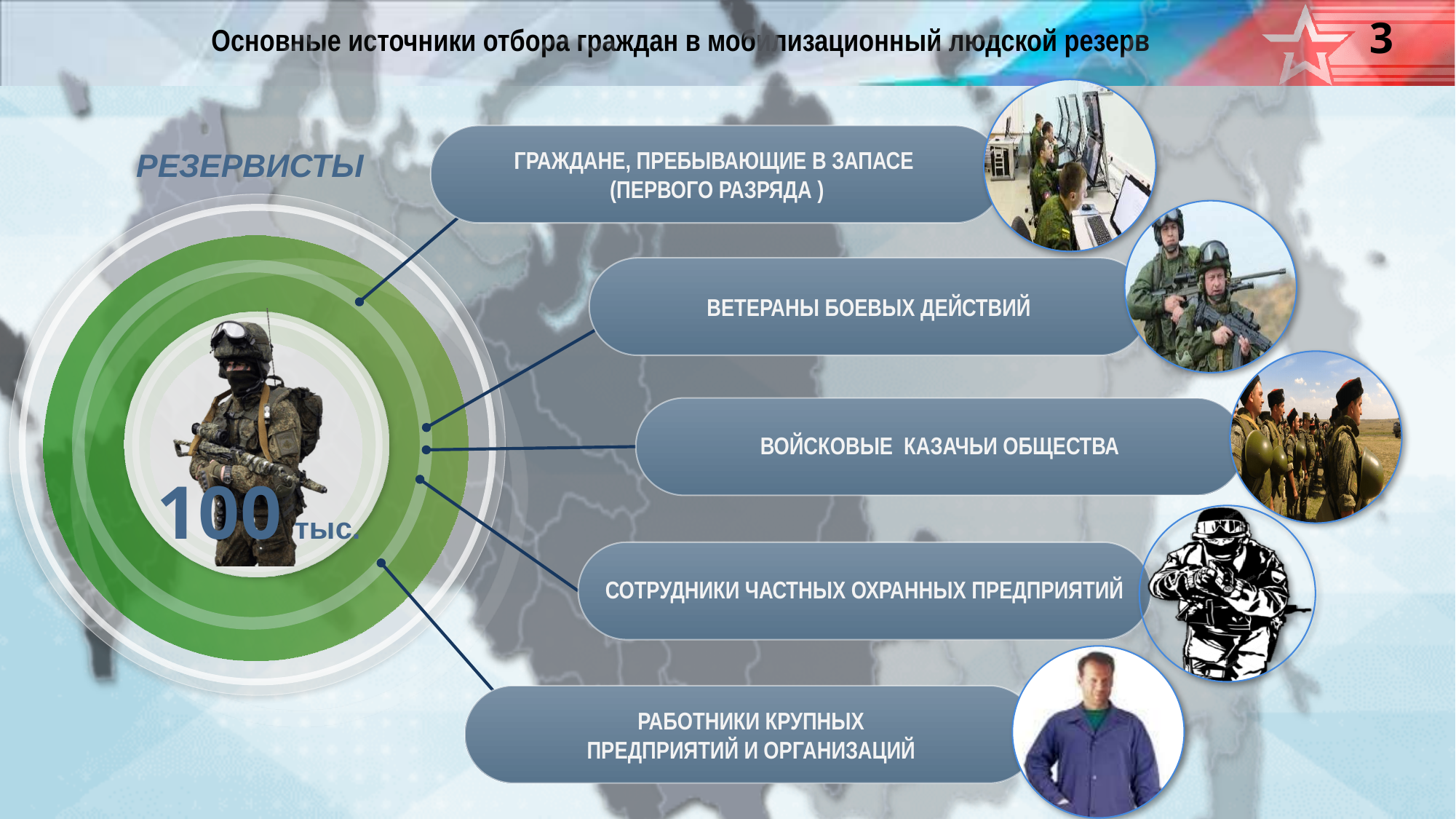
Which source is listed last (at the bottom) in the diagram? РАБОТНИКИ КРУПНЫХ ПРЕДПРИЯТИЙ И ОРГАНИЗАЦИЙ What number is shown in the centre of the circular diagram? 100 тыс. What is the title of the slide? Основные источники отбора граждан в мобилизационный людской резерв Which source is listed third in the diagram? ВОЙСКОВЫЕ КАЗАЧЬИ ОБЩЕСТВА How many sources of selection are listed in the diagram? 5 What label appears above the circular diagram on the left? РЕЗЕРВИСТЫ Which source is listed first (at the top) in the diagram? ГРАЖДАНЕ, ПРЕБЫВАЮЩИЕ В ЗАПАСЕ (ПЕРВОГО РАЗРЯДА)